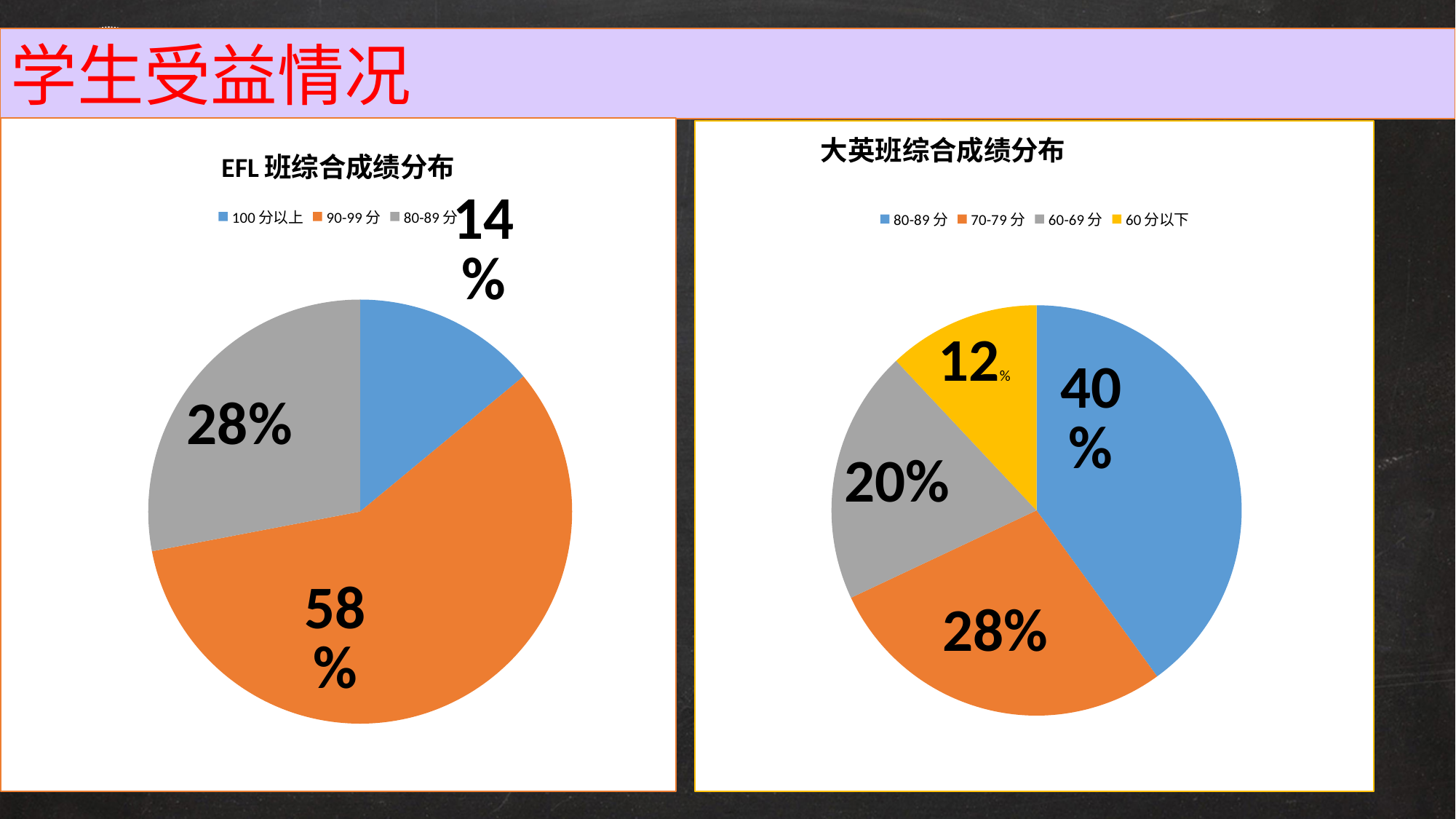
How many categories does the legend of the 大英班综合成绩分布 chart list? 4 In the 大英班综合成绩分布 chart, what share of students scored 80-89 分? 40% In the EFL 班综合成绩分布 chart, what share of students scored 90-99 分? 58% In the EFL 班综合成绩分布 chart, which score band has the largest slice? 90-99 分 In the 大英班综合成绩分布 chart, which score band has the largest slice? 80-89 分 In the 大英班综合成绩分布 chart, which is larger, the 70-79 分 slice or the 60-69 分 slice? 70-79 分 In the EFL 班综合成绩分布 chart, what share of students scored 100 分以上? 14% In the EFL 班综合成绩分布 chart, which score band has the smallest slice? 100 分以上 In the 大英班综合成绩分布 chart, what share of students scored 60 分以下? 12% In the EFL 班综合成绩分布 chart, how many percentage points larger is the 80-89 分 slice than the 100 分以上 slice? 14 In the 大英班综合成绩分布 chart, how many percentage points larger is the 80-89 分 slice than the 70-79 分 slice? 12 What type of chart is the EFL 班综合成绩分布 chart? Pie chart